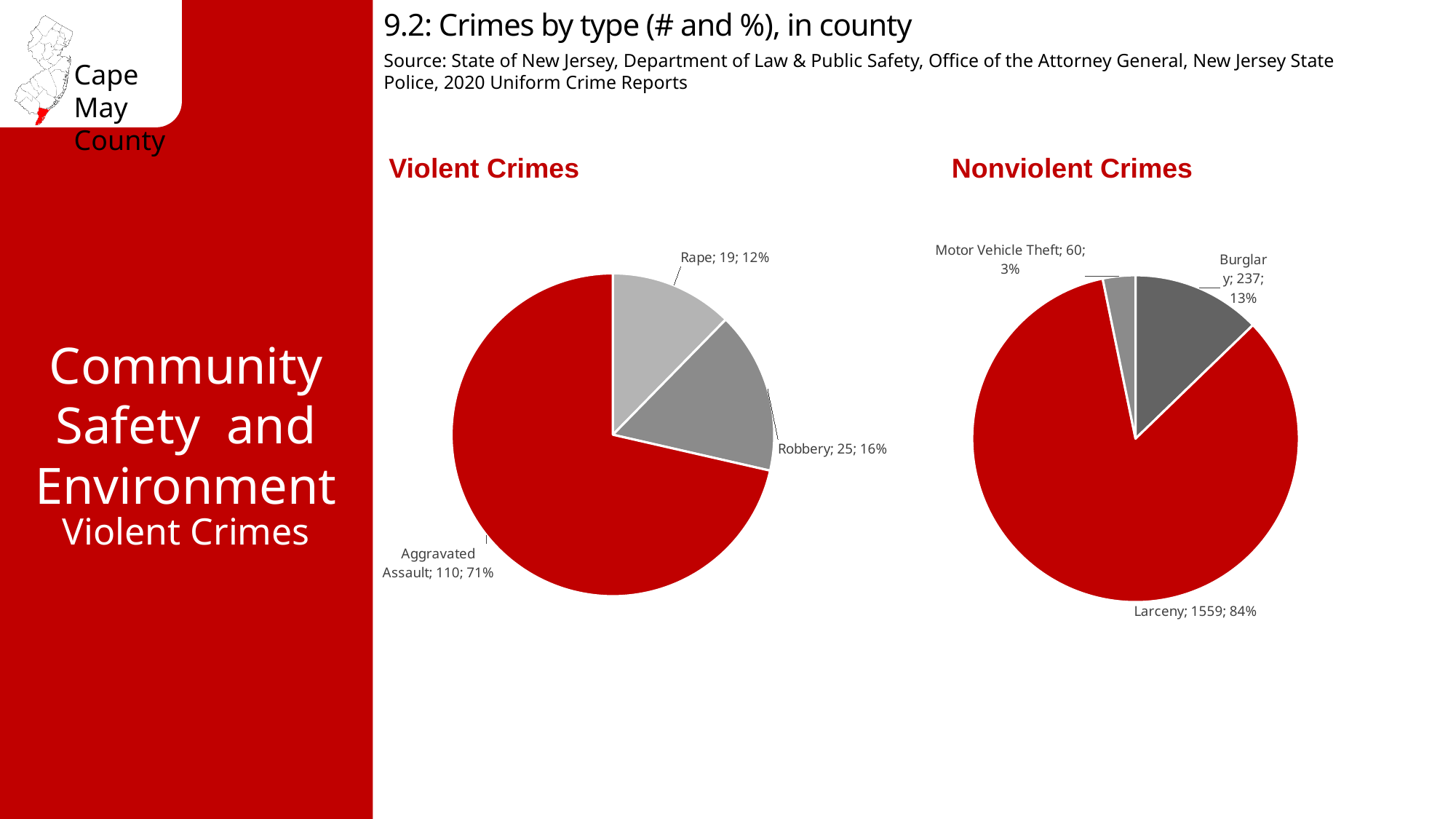
In the Violent Crimes chart, which category has the smallest slice? Rape In the Violent Crimes chart, what share of the pie is Robbery? 16% In the Nonviolent Crimes chart, which is larger, Burglary or Motor Vehicle Theft? Burglary In the Nonviolent Crimes chart, what share of the pie is Motor Vehicle Theft? 3% What kind of chart is the Nonviolent Crimes chart? Pie chart In the Nonviolent Crimes chart, what is the difference between the number of Burglary and Motor Vehicle Theft crimes? 177 In the Violent Crimes chart, how many Aggravated Assault crimes are shown? 110 In the Violent Crimes chart, how many categories are shown? 3 What is the title of the slide's chart section? 9.2: Crimes by type (# and %), in county In the Nonviolent Crimes chart, how many Larceny crimes are shown? 1559 In the Violent Crimes chart, what is the difference between the number of Robbery and Rape crimes? 6 In the Nonviolent Crimes chart, which category has the largest slice? Larceny